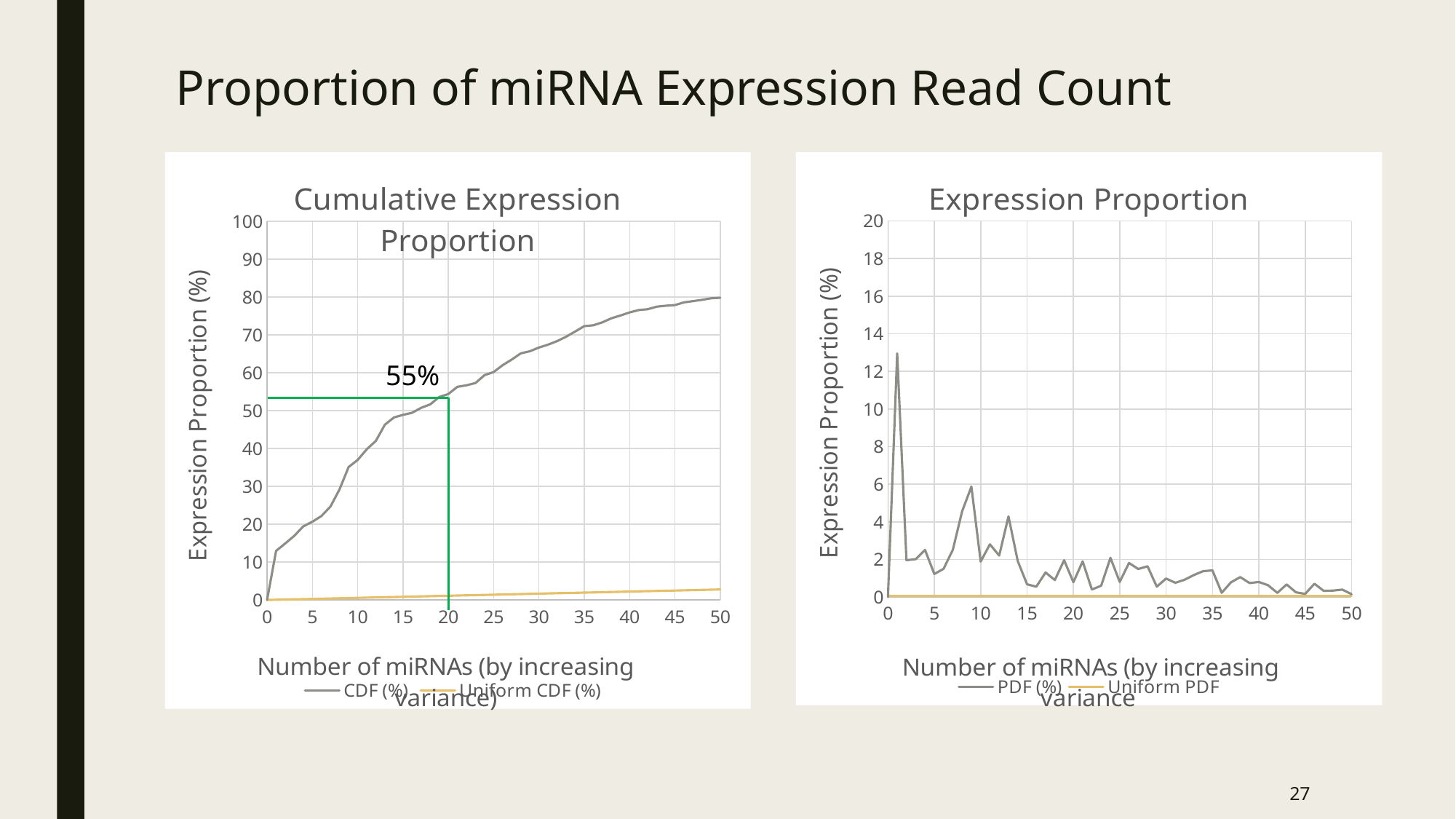
What kind of chart is the 'Cumulative Expression Proportion' chart? line chart In the 'Expression Proportion' chart, is the peak PDF (%) value near 1 miRNA greater or less than 10? greater In the 'Expression Proportion' chart, is the PDF (%) value at 50 miRNAs greater or less than 2? less How many series does the legend of the 'Cumulative Expression Proportion' chart list? 2 In the 'Cumulative Expression Proportion' chart, does the CDF (%) rise or fall as the number of miRNAs increases? rise What kind of chart is the 'Expression Proportion' chart? line chart In the 'Cumulative Expression Proportion' chart, what value is annotated for the CDF (%) at 20 miRNAs? 55% In the 'Cumulative Expression Proportion' chart, is the CDF (%) value at 50 miRNAs greater or less than 70? greater In the 'Cumulative Expression Proportion' chart, which series is higher at 50 miRNAs, CDF (%) or Uniform CDF (%)? CDF (%) How many series does the legend of the 'Expression Proportion' chart list? 2 What is the y-axis label of the 'Cumulative Expression Proportion' chart? Expression Proportion (%) What are the two legend entries of the 'Expression Proportion' chart? PDF (%) and Uniform PDF